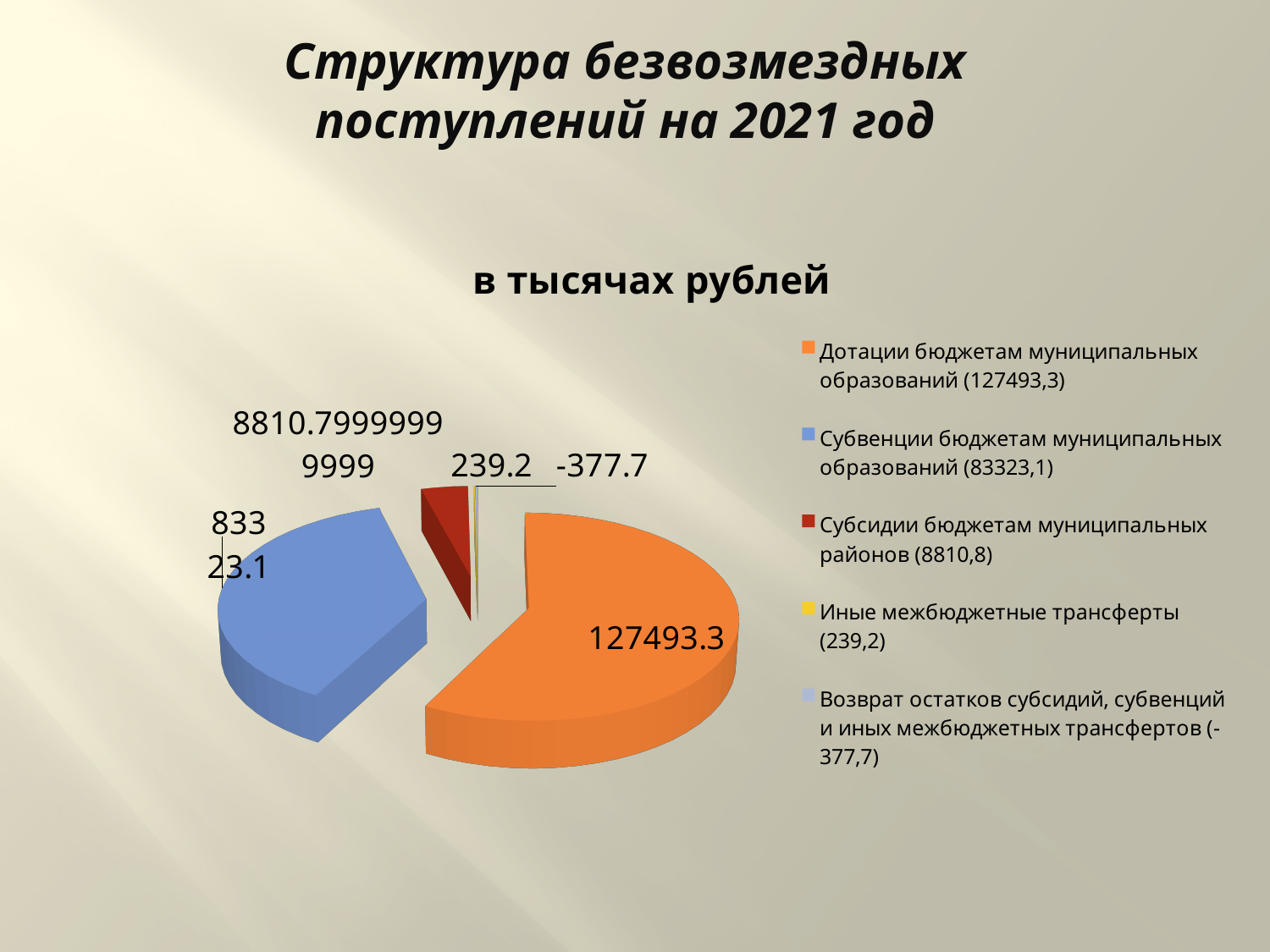
What is the value shown for Возврат остатков субсидий, субвенций и иных межбюджетных трансфертов? -377.7 What is the value shown for Дотации бюджетам муниципальных образований? 127493.3 What is the difference between the values for Дотации бюджетам муниципальных образований (127493.3) and Иные межбюджетные трансферты (239.2)? 127254.1 According to the legend, what value is given for Субсидии бюджетам муниципальных районов? 8810,8 What is the title of the chart? в тысячах рублей How many categories does the legend of the pie chart list? 5 Which category has the lowest value? Возврат остатков субсидий, субвенций и иных межбюджетных трансфертов What kind of chart is shown on the slide? pie chart Which category has the largest slice of the pie? Дотации бюджетам муниципальных образований What is the value shown for Иные межбюджетные трансферты? 239.2 What colour is the slice for Субвенции бюджетам муниципальных образований? blue Which is larger: Субвенции бюджетам муниципальных образований or Субсидии бюджетам муниципальных районов? Субвенции бюджетам муниципальных образований